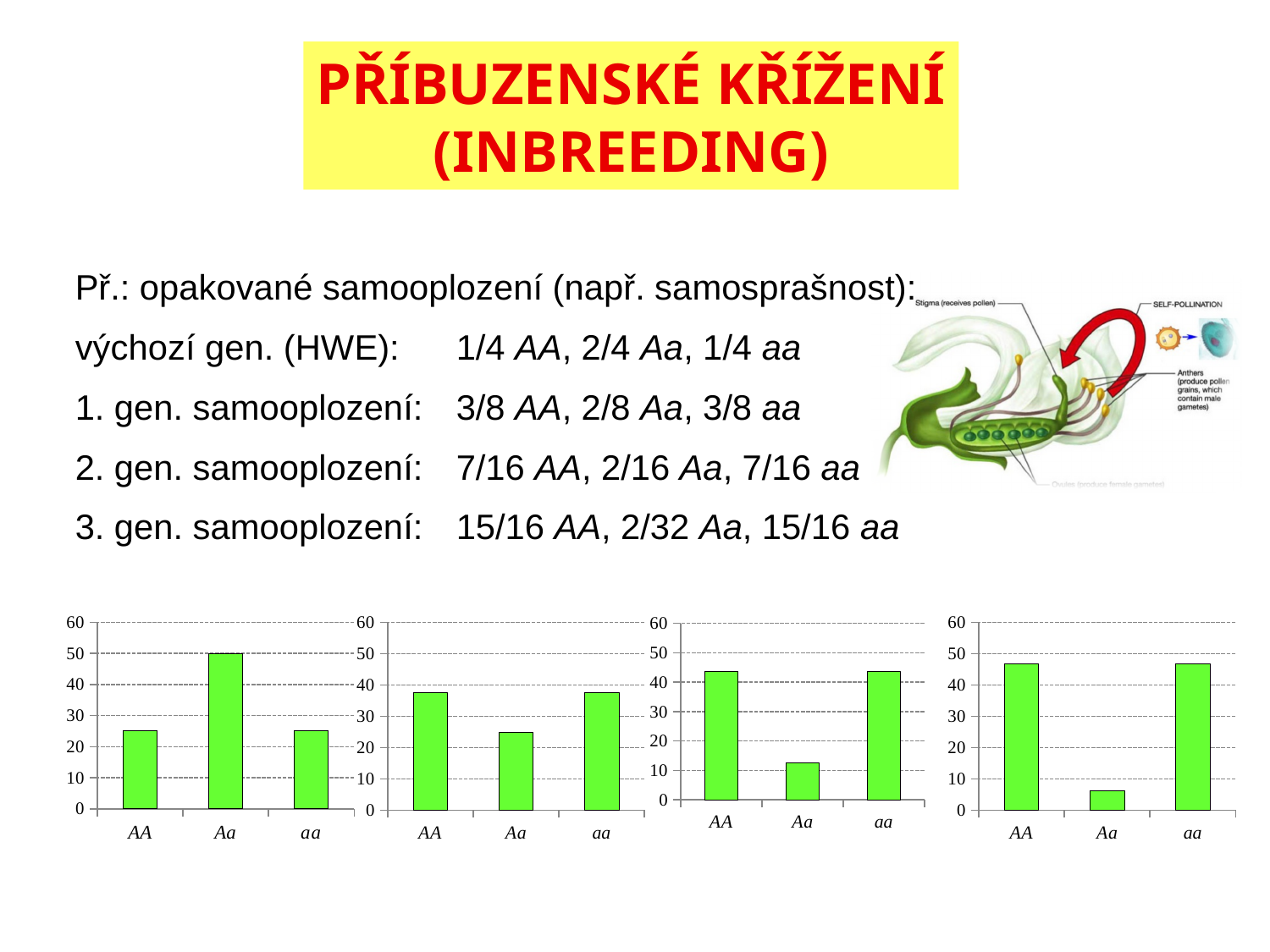
In the rightmost chart, is the value for aa greater or less than 40? greater In the second chart from the left, is the value for AA greater or less than 30? greater In the rightmost chart, is the value for Aa greater or less than 10? less In the third chart from the left, which is larger, the value for AA or the value for Aa? AA In the rightmost chart, which category has the lowest value? Aa What kind of chart is the rightmost chart? bar chart In the leftmost chart, which category has the highest value? Aa In the leftmost chart, what is the value for Aa? 50 In the second chart from the left, which category has the lowest value? Aa How many categories are shown on the x axis of the leftmost chart? 3